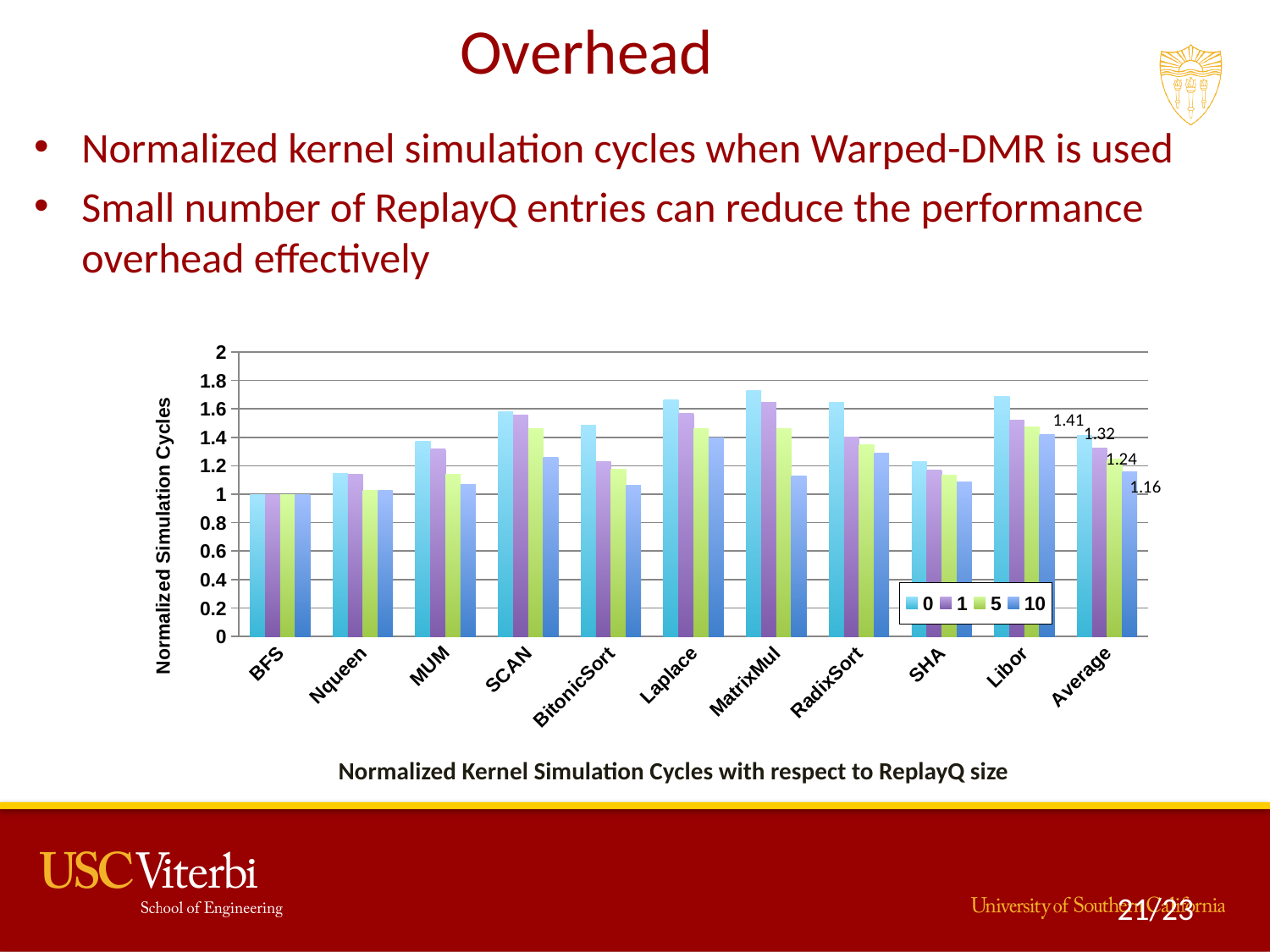
What is the value of the '5' series for the Average category? 1.24 Is the value of the '10' series for MatrixMul greater or less than 1.2? less What kind of chart is shown on the slide? bar chart What is the value of the '0' series for the Average category? 1.41 What is the value of the '10' series for the Average category? 1.16 Which category has the lowest values across all series? BFS Is the value of the '0' series for SCAN greater or less than 1.4? greater For the '0' series, which is larger: Libor or SHA? Libor How many benchmark categories are shown on the x axis of the chart? 11 What is the title of the y axis? Normalized Simulation Cycles How many series does the legend list? 4 For the Average category, what is the difference between the '0' series value and the '10' series value? 0.25